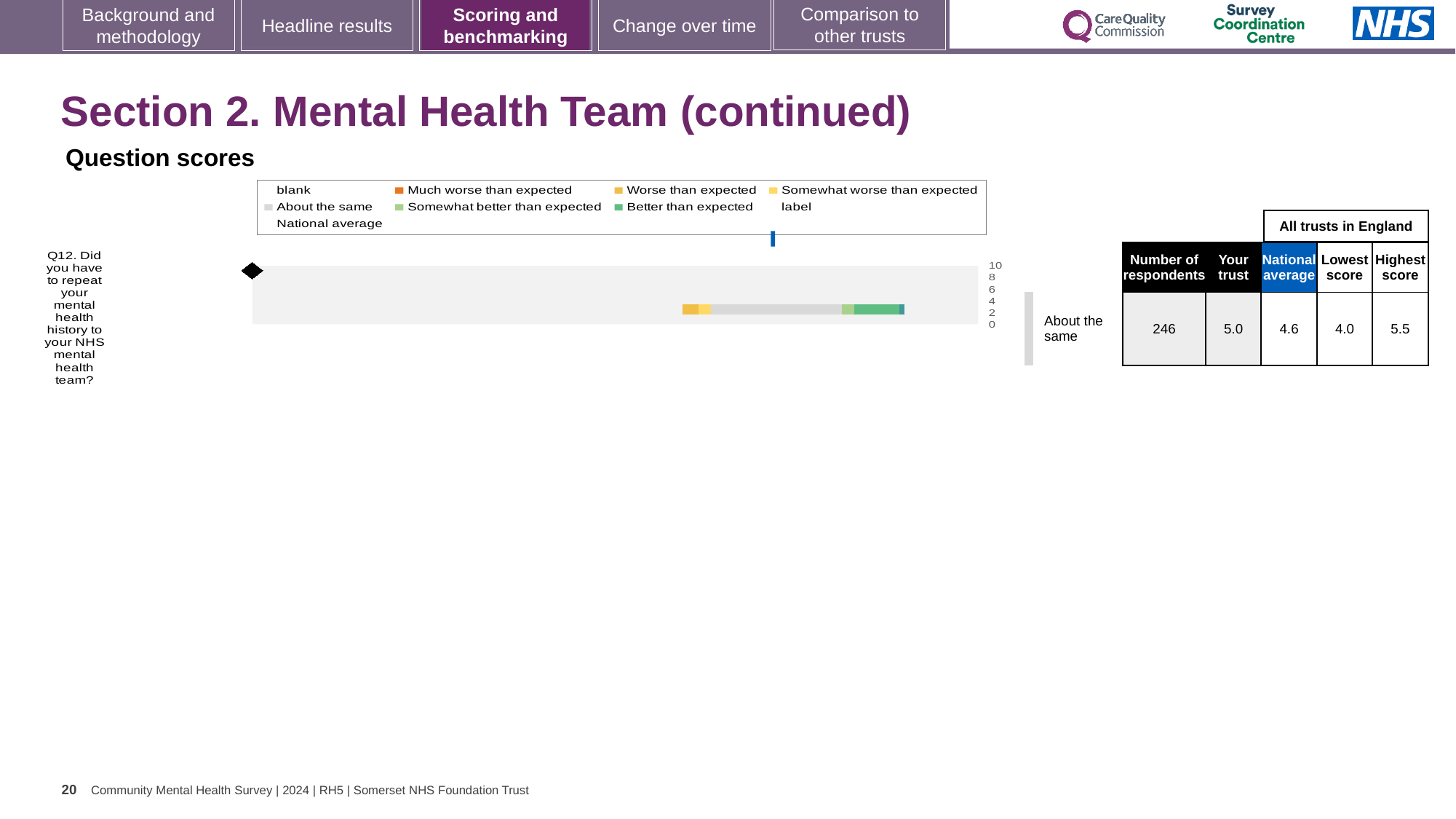
What rating label is shown next to the Q12 bar in the Question scores chart? About the same What is the highest value shown on the axis of the Question scores chart? 10 For Q12, which is larger: the 'Your trust' score or the national average score? Your trust For Q12, what is the difference between the highest score and the lowest score among all trusts in England? 1.5 How many survey questions are plotted in the Question scores chart? 1 In the table beside the Question scores chart, what is the highest score among all trusts in England for Q12? 5.5 In the table beside the Question scores chart, what is the national average score for Q12? 4.6 Which question is plotted in the Question scores chart? Q12. Did you have to repeat your mental health history to your NHS mental health team? In the table beside the Question scores chart, what is the 'Your trust' score for Q12? 5.0 In the table beside the Question scores chart, what is the lowest score among all trusts in England for Q12? 4.0 In the table beside the Question scores chart, what is the number of respondents for Q12? 246 What kind of chart is shown under 'Question scores'? bar chart